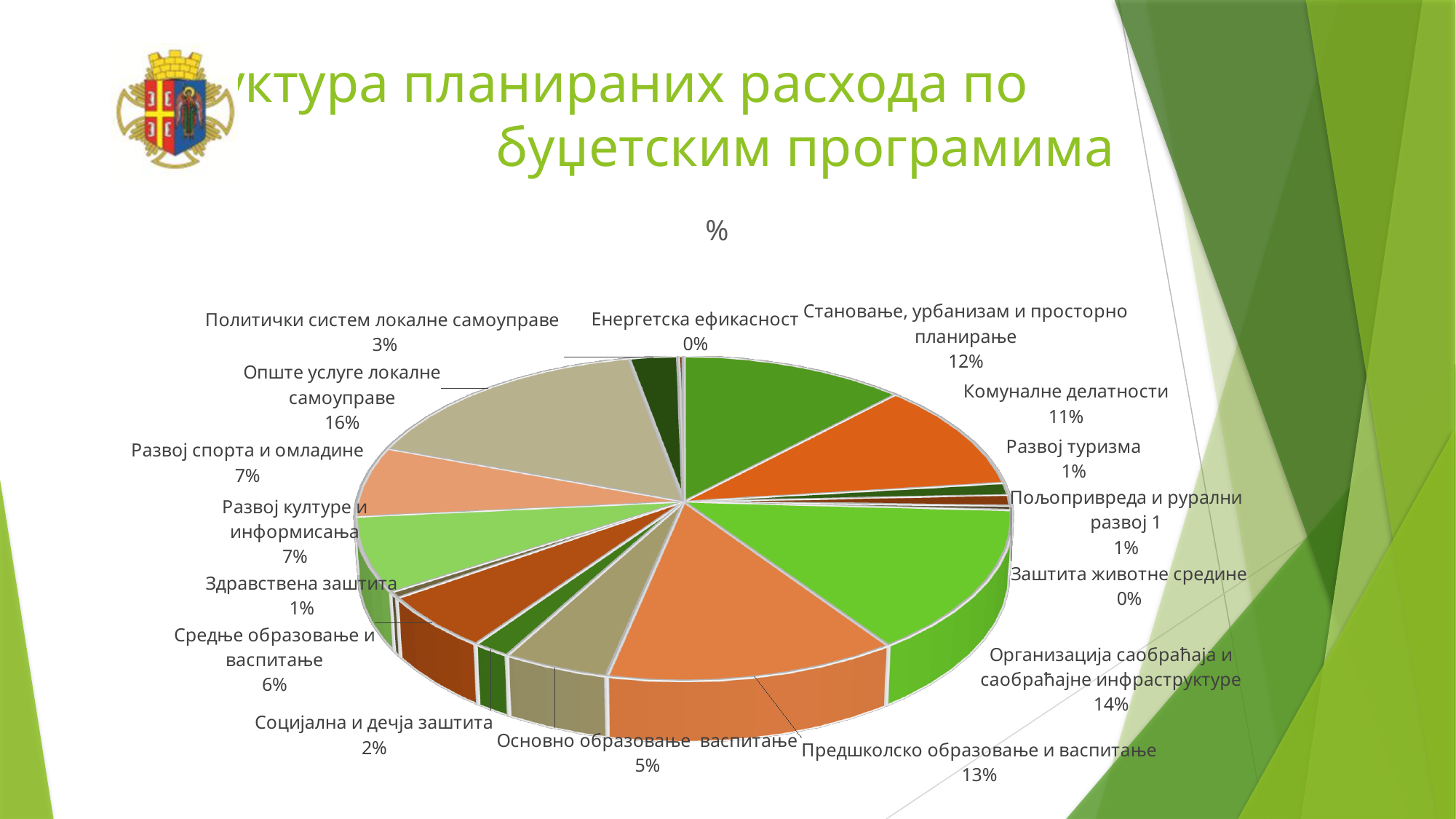
What kind of chart is shown on the slide? pie chart What is the value for Средње образовање и васпитање? 6% What is the value for Организација саобраћаја и саобраћајне инфраструктуре? 14% What is the difference between Становање, урбанизам и просторно планирање and Политички систем локалне самоуправе? 9% What share of the pie is Опште услуге локалне самоуправе? 16% What is the value for Енергетска ефикасност? 0% How many categories does the pie chart have? 16 What is the chart's title? % Which is larger, Предшколско образовање и васпитање or Основно образовање васпитање? Предшколско образовање и васпитање Which category has the largest share of the pie? Опште услуге локалне самоуправе What is the value for Комуналне делатности? 11% What is the value for Предшколско образовање и васпитање? 13%